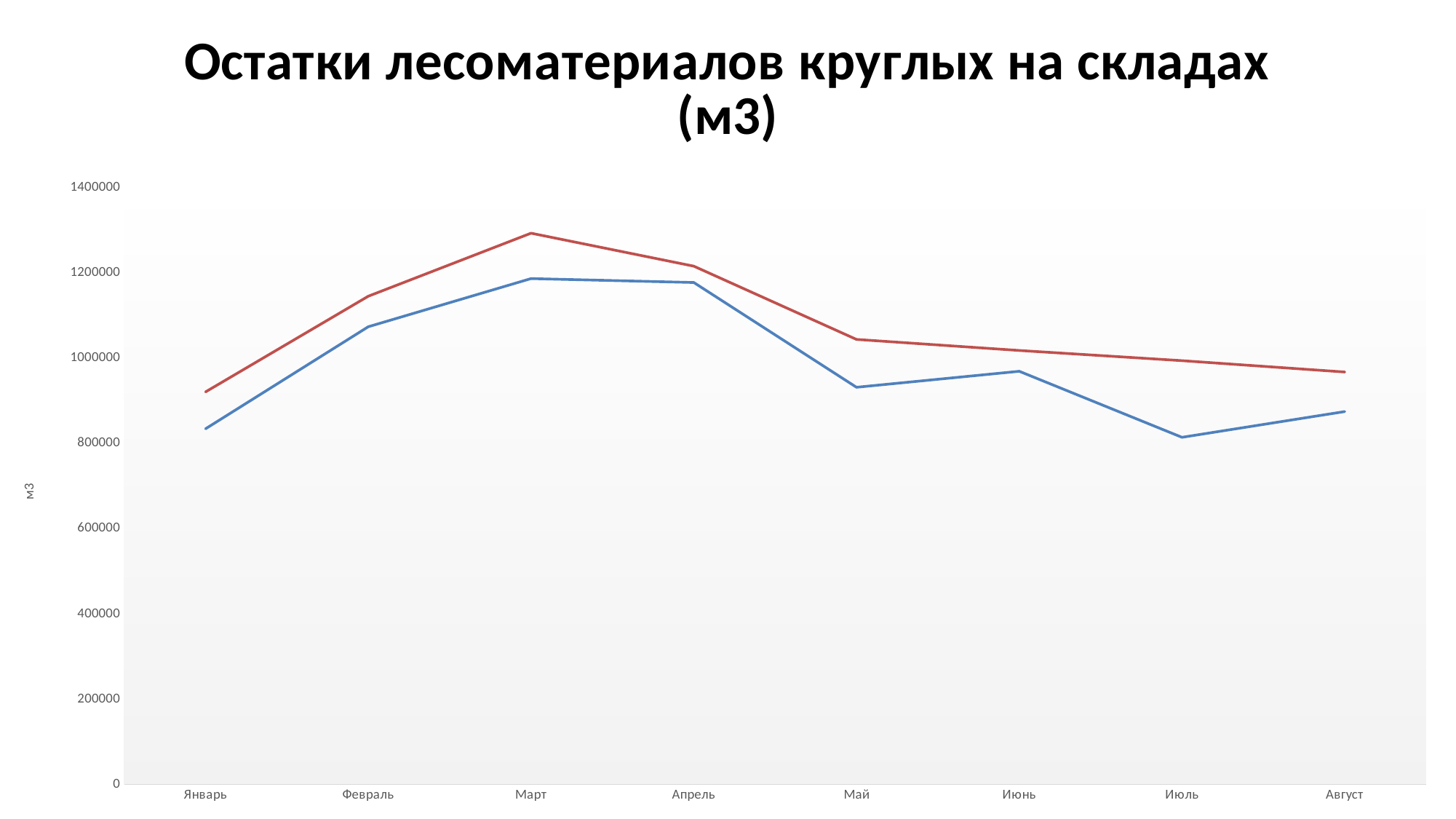
What is the title of the chart? Остатки лесоматериалов круглых на складах (м3) Is the value of the blue line in Апрель greater or less than 1000000? greater What kind of chart is shown on the slide? line chart How many months are plotted along the x axis? 8 How many lines (series) are plotted on the chart? 2 Does the red line rise or fall from Март to Август? fall Is the value of the red line in Март greater or less than 1200000? greater In Январь, which line has the higher value, the red line or the blue line? the red line In which month does the red line reach its highest value? Март Is the value of the blue line in Июль greater or less than 1000000? less In which month does the red line have its lowest value? Январь